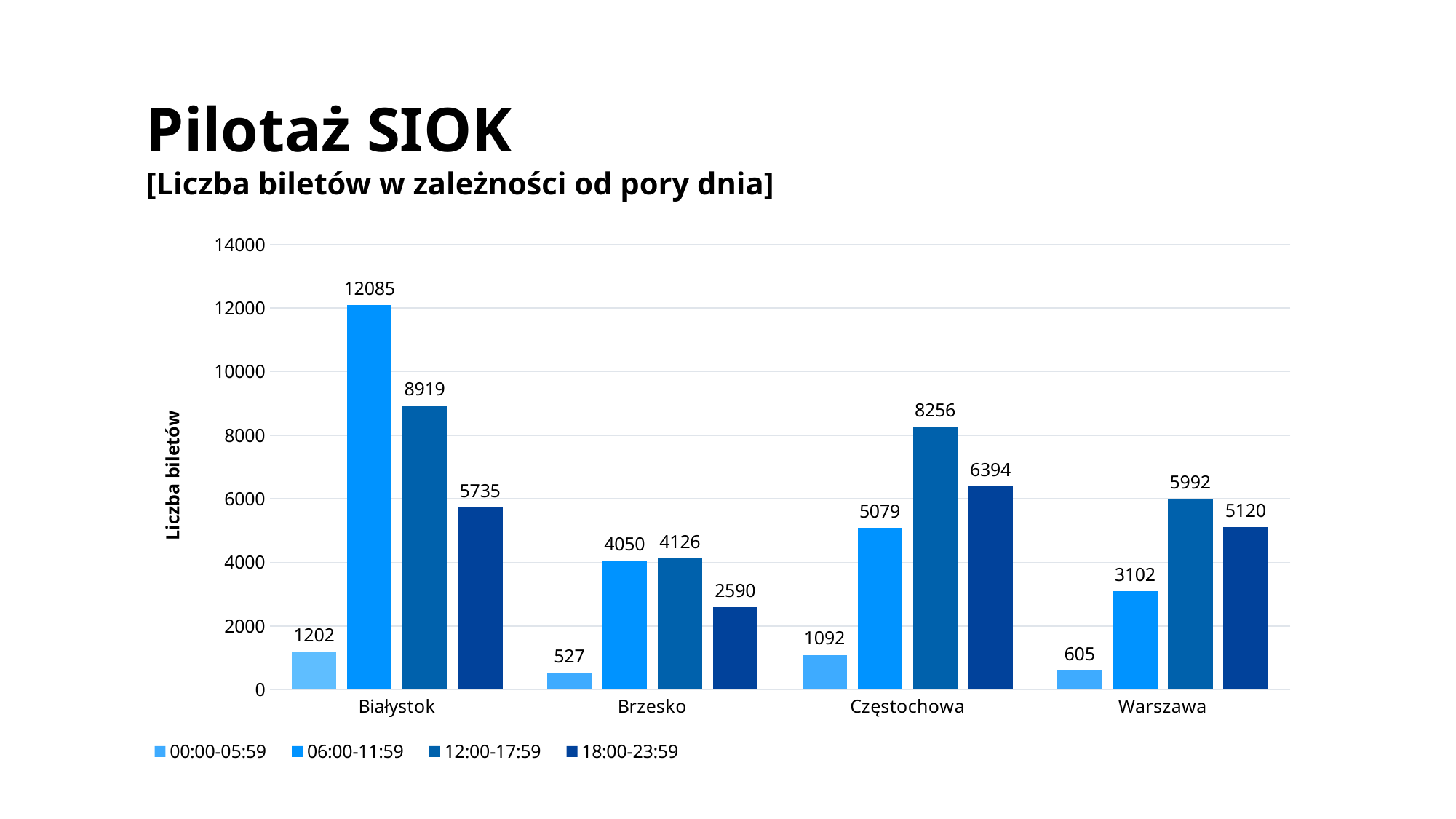
What is the number of tickets for Warszawa in the 12:00-17:59 period? 5992 What is the number of tickets for Białystok in the 06:00-11:59 period? 12085 Which is larger for Częstochowa: the 12:00-17:59 value or the 18:00-23:59 value? 12:00-17:59 Which city has the highest number of tickets in the 18:00-23:59 period? Częstochowa Which city has the lowest number of tickets in the 06:00-11:59 period? Warszawa How many series does the legend list? 4 What is the difference between the 06:00-11:59 and 12:00-17:59 values for Białystok? 3166 What is the label of the y axis? Liczba biletów What kind of chart is shown on the slide? Bar chart How many cities are shown on the x axis? 4 What is the number of tickets for Brzesko in the 00:00-05:59 period? 527 What is the total number of tickets for Warszawa across all four time periods? 14819